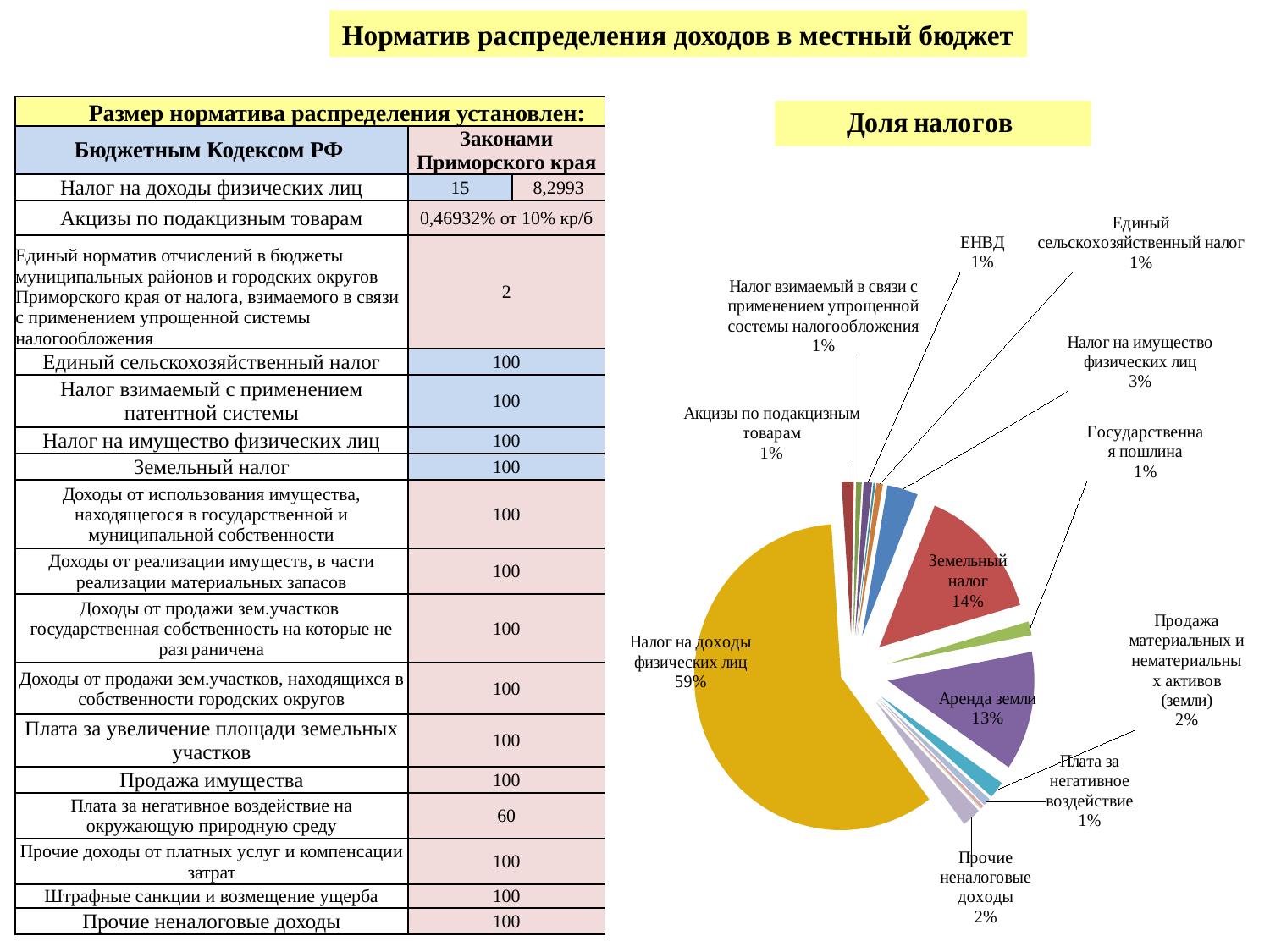
In the pie chart "Доля налогов", which is larger: "Земельный налог" or "Аренда земли"? Земельный налог In the pie chart "Доля налогов", what share does "Аренда земли" have? 13% In the pie chart "Доля налогов", which slice is the largest? Налог на доходы физических лиц What is the title of the pie chart on the right side of the slide? Доля налогов In the pie chart "Доля налогов", what share does "Прочие неналоговые доходы" have? 2% In the pie chart "Доля налогов", what is the difference in percentage points between "Налог на доходы физических лиц" and "Земельный налог"? 45 How many slices does the pie chart "Доля налогов" have? 15 In the pie chart "Доля налогов", what share does "Земельный налог" have? 14% What type of chart is shown under the title "Доля налогов"? pie chart In the pie chart "Доля налогов", what share does "Налог на доходы физических лиц" have? 59% In the pie chart "Доля налогов", what share does "Налог на имущество физических лиц" have? 3% In the pie chart "Доля налогов", what is the difference in percentage points between "Аренда земли" and "Налог на имущество физических лиц"? 10